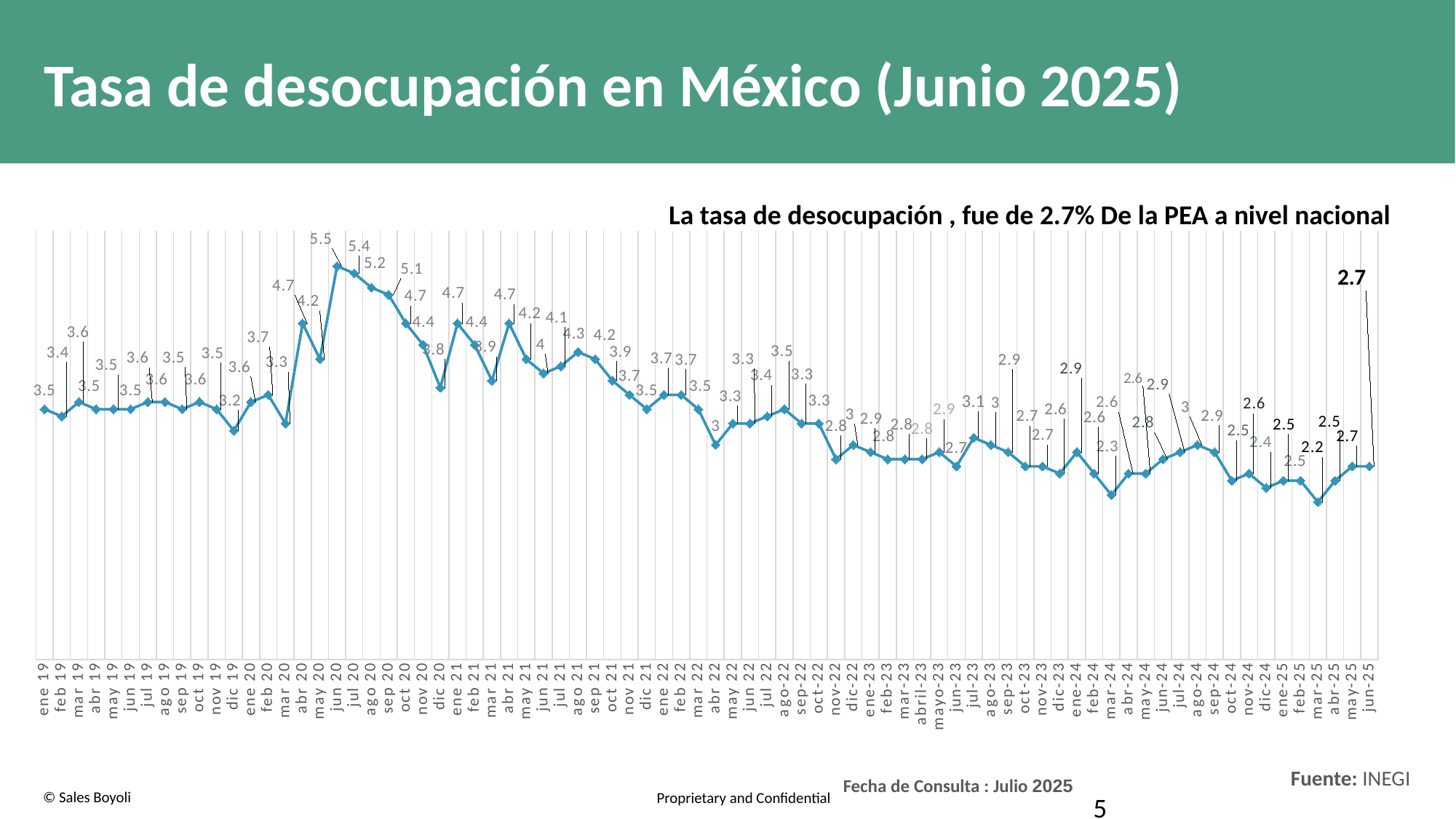
What kind of chart is shown on the slide? line chart What is the unemployment rate for ene 19? 3.5 What is the title of the slide? Tasa de desocupación en México (Junio 2025) Which month has the lowest unemployment rate in the chart? mar-25 What is the unemployment rate for jun-25? 2.7 Does the unemployment rate rise or fall from jun 20 to dic 20? fall What is the unemployment rate for dic 19? 3.2 What is the highest value shown in the chart? 5.5 Which is larger, the value for abr 20 or the value for may 20? abr 20 What is the difference between the value for jun 20 and the value for jun-25? 2.8 What is the unemployment rate for mar-24? 2.3 Which month has the highest unemployment rate in the chart? jun 20